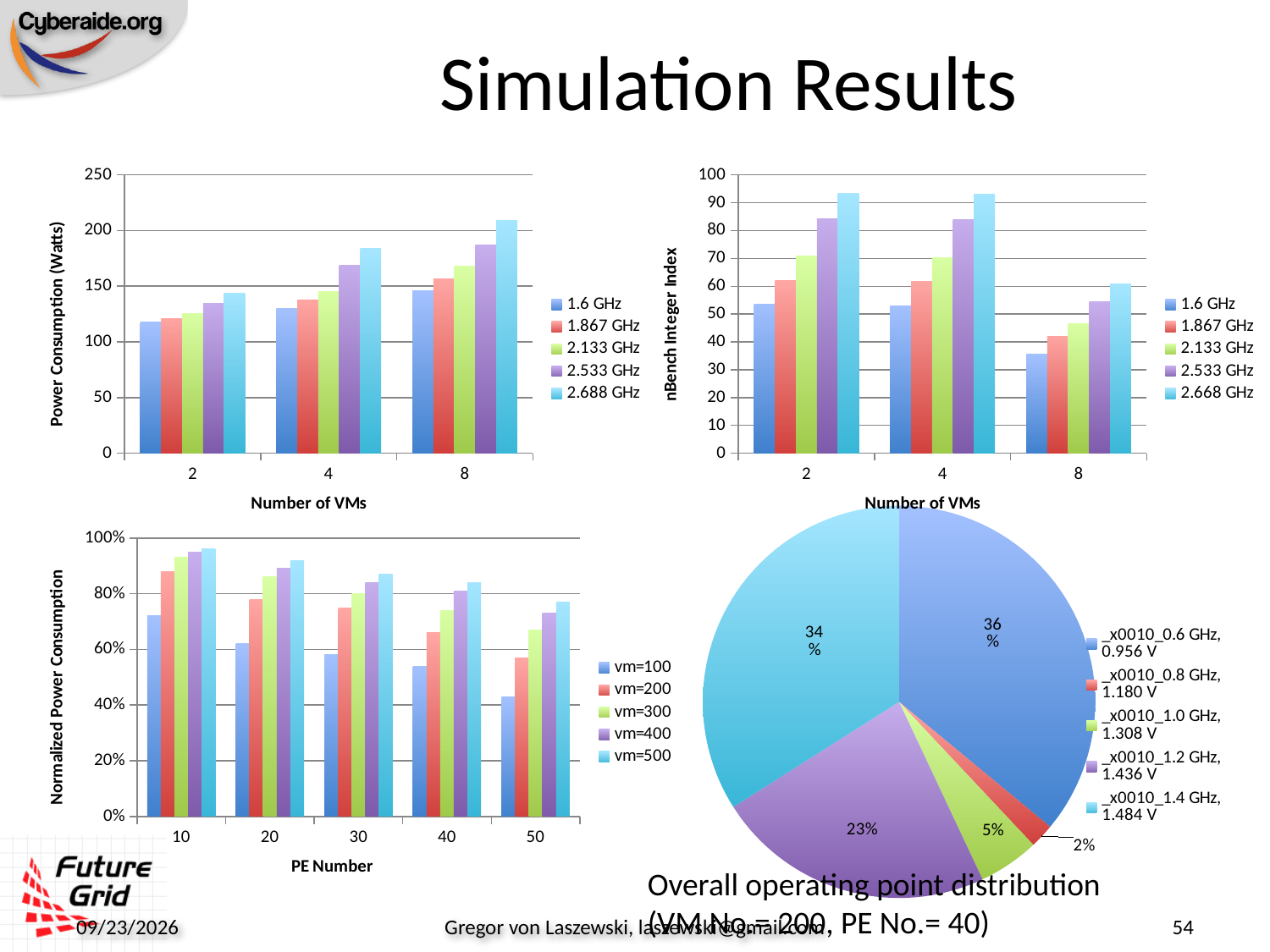
In the top-left chart (Power Consumption vs Number of VMs), how many series does the legend list? 5 In the top-left chart (Power Consumption vs Number of VMs), is the value for 2.688 GHz at 8 VMs greater or less than 200? greater In the pie chart (Overall operating point distribution), what share does the 1.2 GHz, 1.436 V operating point have? 23% In the pie chart (Overall operating point distribution), which operating point has the smallest share? 0.8 GHz, 1.180 V In the top-right chart (nBench Integer Index vs Number of VMs), is the value for 1.6 GHz at 8 VMs greater or less than 40? less In the bottom-left chart (Normalized Power Consumption vs PE Number), is the value for vm=500 at PE Number 10 greater or less than 80%? greater In the pie chart (Overall operating point distribution), which operating point has the largest share? 0.6 GHz, 0.956 V What kind of chart is the top-left chart showing Power Consumption (Watts) against Number of VMs? bar chart In the top-right chart (nBench Integer Index vs Number of VMs), at 2 VMs, which is larger: 2.533 GHz or 1.867 GHz? 2.533 GHz In the pie chart (Overall operating point distribution), how many percentage points larger is the 0.6 GHz, 0.956 V slice than the 1.4 GHz, 1.484 V slice? 2 In the pie chart (Overall operating point distribution), how many slices are there? 5 In the top-left chart (Power Consumption vs Number of VMs), does the power consumption for 1.6 GHz rise or fall as the number of VMs increases from 2 to 8? rise